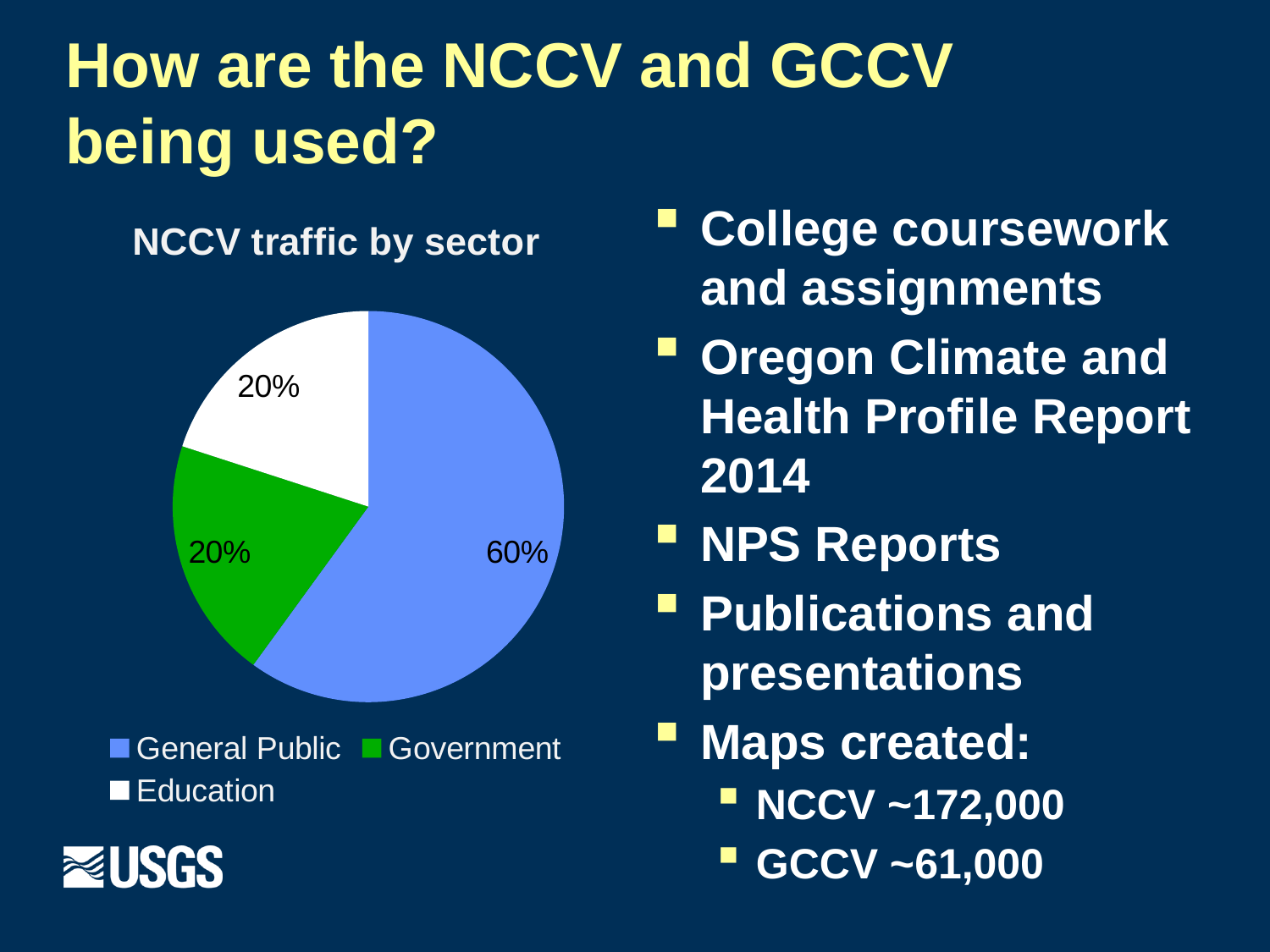
What is the title of the chart? NCCV traffic by sector What share of the pie does the General Public slice represent? 60% What is the difference in percentage points between the General Public and Government shares? 40 How many slices does the pie chart have? 3 What percentage of NCCV traffic comes from the General Public? 60% What colour is the General Public slice? blue How many entries does the legend list? 3 Which sector accounts for the largest share of NCCV traffic? General Public What kind of chart is shown on the slide? pie chart Which is larger, the General Public share or the Education share? General Public What percentage of NCCV traffic comes from Education? 20% What percentage of NCCV traffic comes from Government? 20%